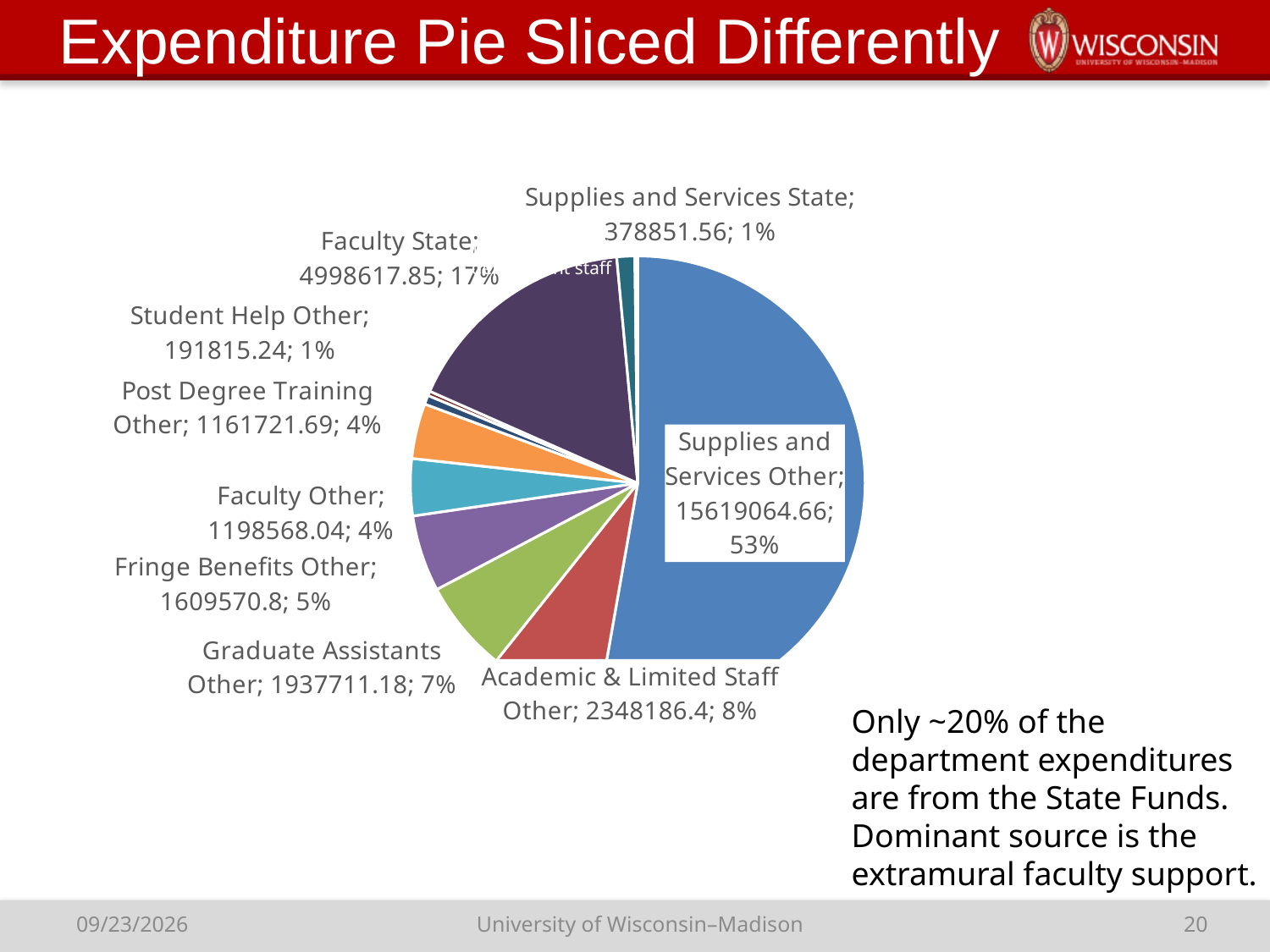
What share of the pie does Post Degree Training Other represent? 4% What is the value for Graduate Assistants Other? 1937711.18 What share of the pie does Faculty State represent? 17% Which is larger, Fringe Benefits Other or Faculty Other? Fringe Benefits Other What share of the pie does Supplies and Services Other represent? 53% What type of chart is shown on the slide? pie chart Which category has the largest slice of the pie? Supplies and Services Other What is the title of the slide containing the chart? Expenditure Pie Sliced Differently What is the value for Academic & Limited Staff Other? 2348186.4 What is the value for Faculty State? 4998617.85 What is the value for Supplies and Services Other? 15619064.66 What is the difference between the values for Academic & Limited Staff Other and Graduate Assistants Other? 410475.22